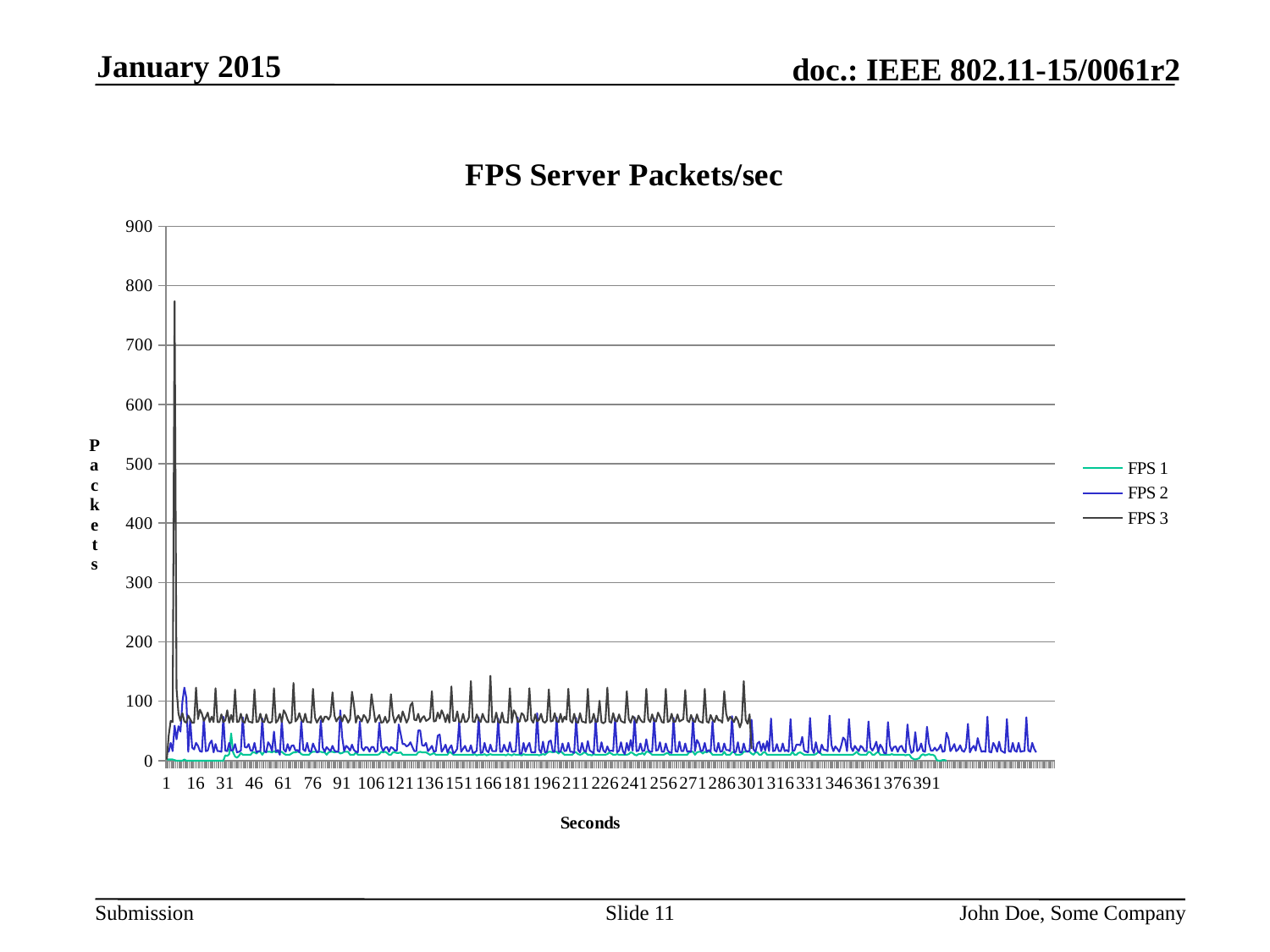
Which series stays lowest across the chart? FPS 1 Is the typical value of FPS 1 greater or less than 100? less Which series has the larger peak value, FPS 2 or FPS 3? FPS 3 What kind of chart is shown on the slide? line chart What is the highest value shown on the y axis? 900 Are the peaks of FPS 2 greater or less than 200? less Is the highest peak of FPS 3 greater or less than 800? less What is the title of the chart? FPS Server Packets/sec What is the label of the x axis? Seconds Which series reaches the highest peak value on the chart? FPS 3 How many series does the legend list? 3